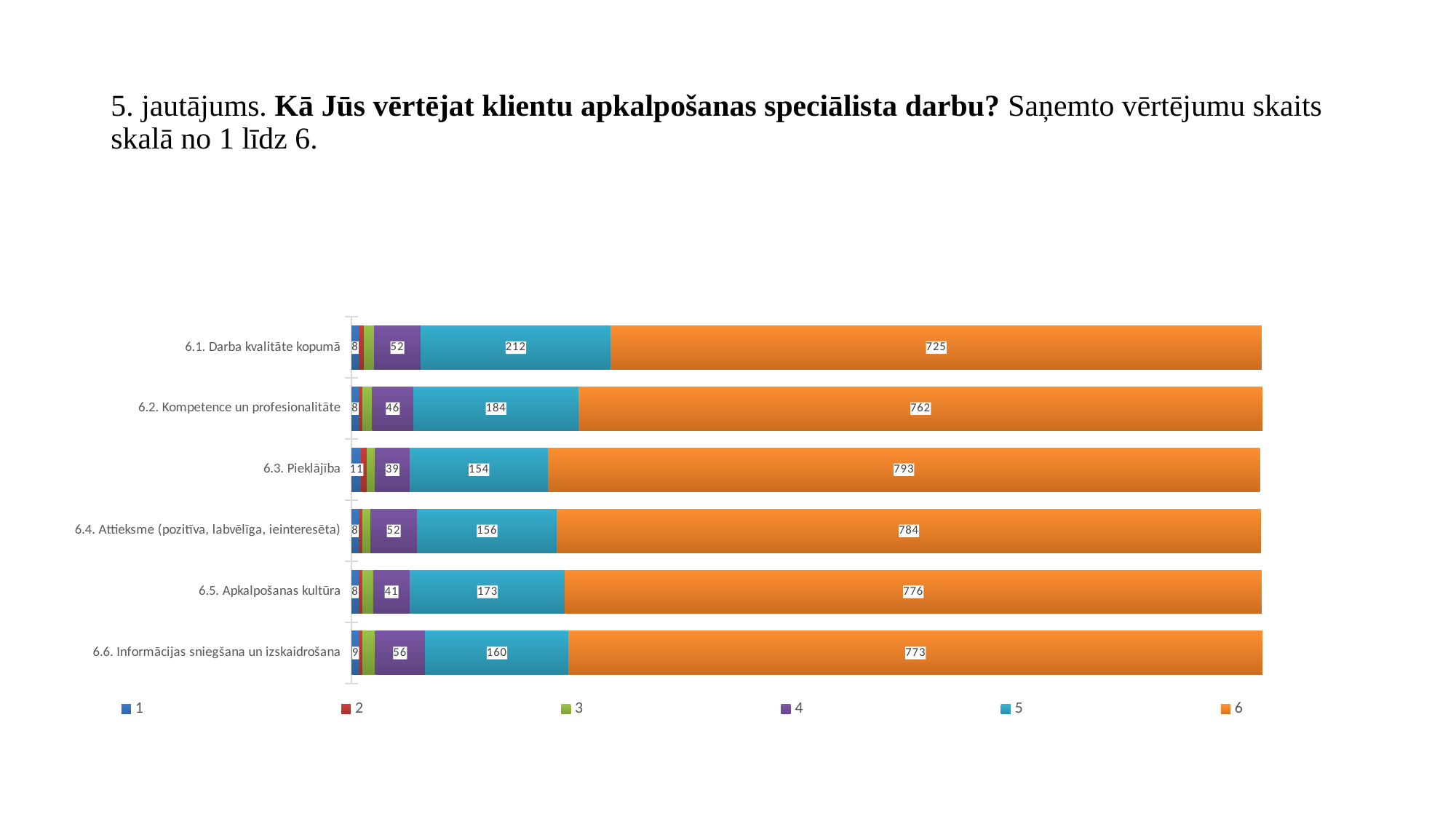
Which category has the highest value for series 6? 6.3. Pieklājība What is the value of series 4 for "6.6. Informācijas sniegšana un izskaidrošana"? 56 What is the value of series 5 for "6.1. Darba kvalitāte kopumā"? 212 Which series is shown in orange in the legend? 6 Which is larger: the series 4 value for "6.4. Attieksme (pozitīva, labvēlīga, ieinteresēta)" or for "6.5. Apkalpošanas kultūra"? 6.4. Attieksme (pozitīva, labvēlīga, ieinteresēta) Which category has the lowest value for series 5? 6.3. Pieklājība What kind of chart is shown on the slide? stacked bar chart How many categories are plotted on the chart? 6 What is the difference between the series 6 values for "6.3. Pieklājība" and "6.1. Darba kvalitāte kopumā"? 68 What is the value of series 6 for "6.3. Pieklājība"? 793 What is the value of series 6 for "6.2. Kompetence un profesionalitāte"? 762 How many series does the legend list? 6